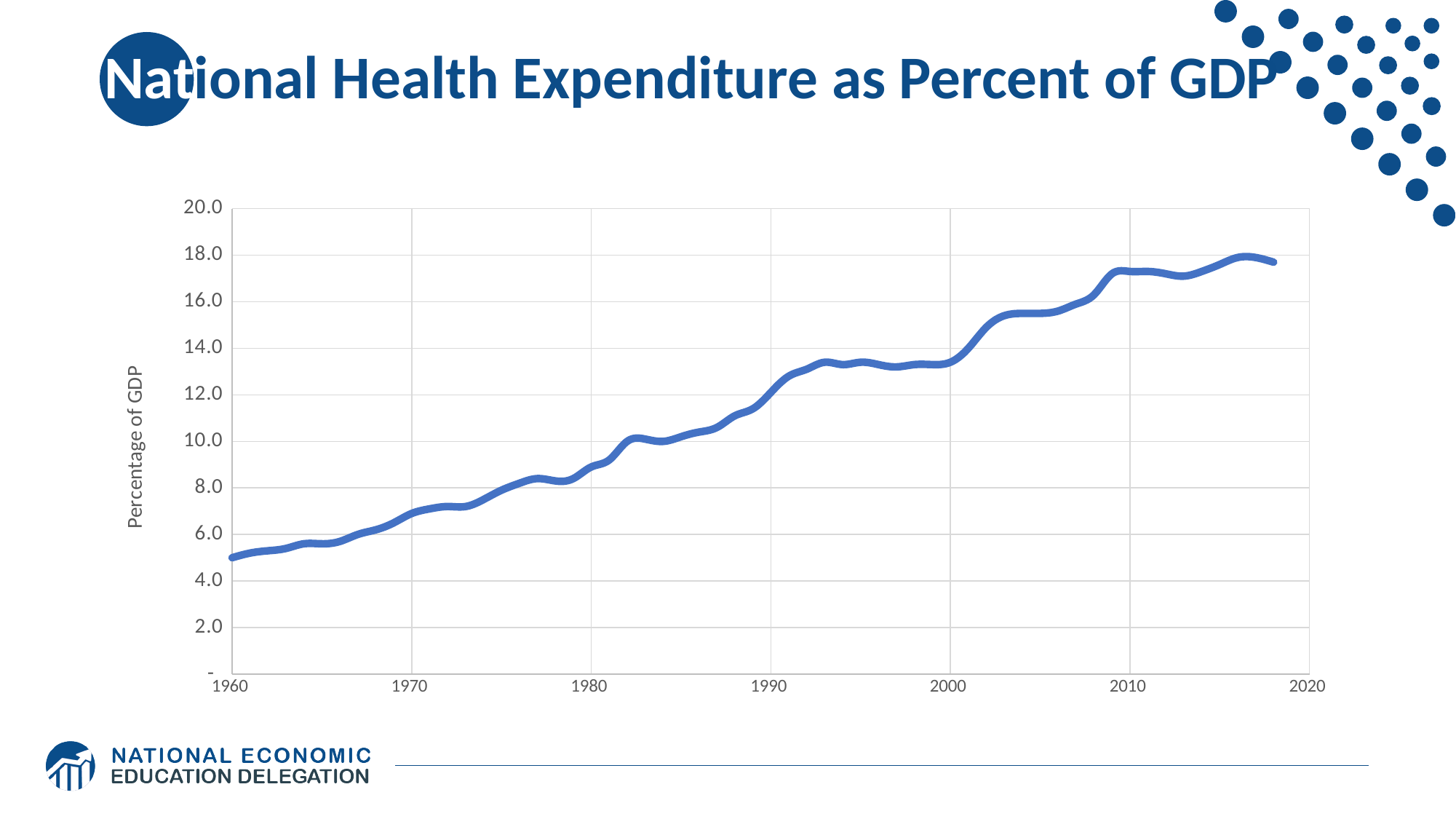
Is the value for 1980 greater or less than 8.0? greater What is the title of the chart? National Health Expenditure as Percent of GDP Which year has the larger value, 1980 or 1990? 1990 Is the value for 1990 greater or less than 10.0? greater What kind of chart is shown on the slide? line chart Is the value for 1970 greater or less than 8.0? less Overall, does the value rise or fall from 1960 to 2020? rise What is the label on the vertical axis? Percentage of GDP Which year has the larger value, 2000 or 2010? 2010